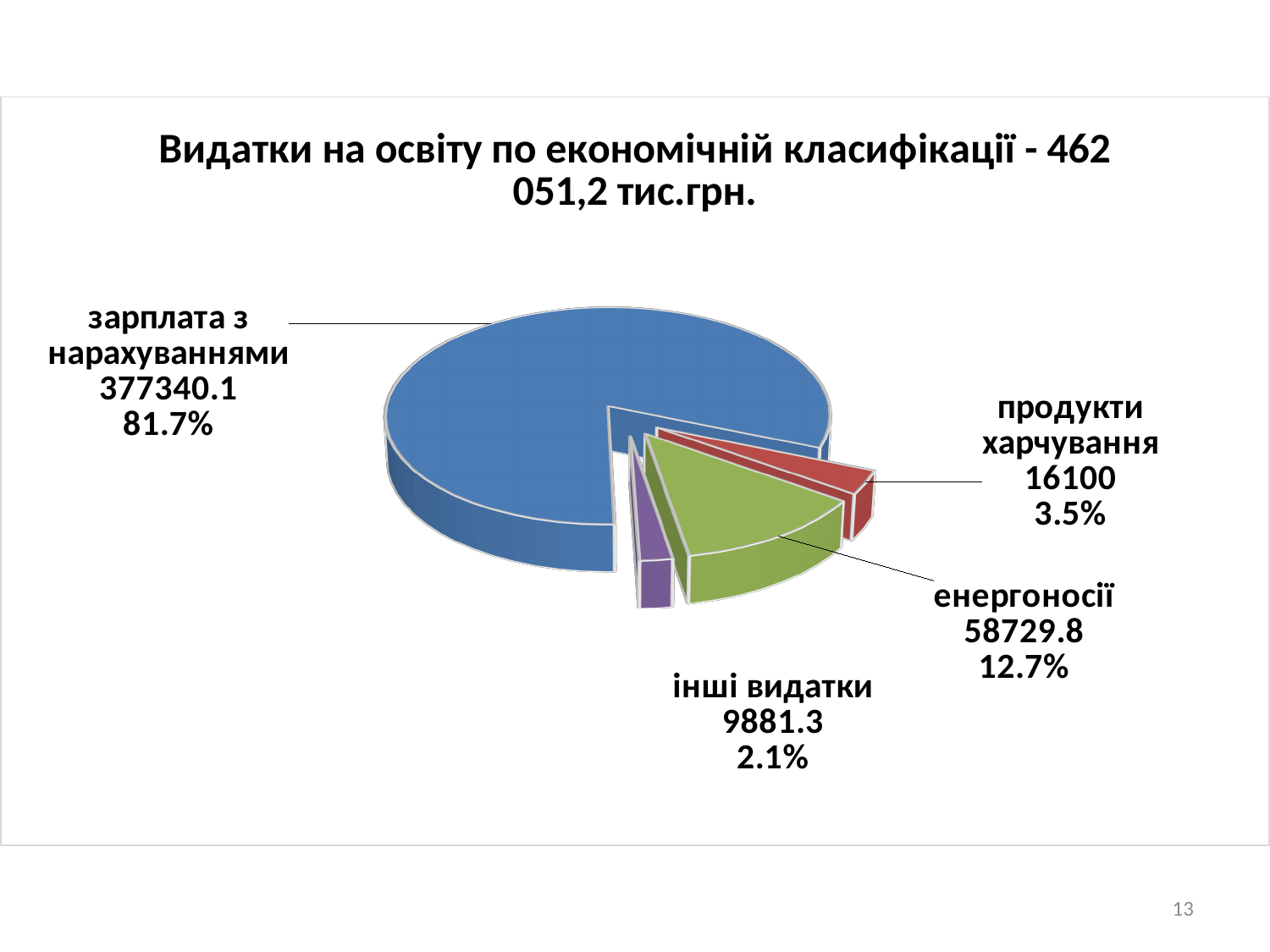
What is the value for енергоносії? 58729.8 What kind of chart is shown on the slide? pie chart Which category has the smallest slice? інші видатки What is the value for інші видатки? 9881.3 What share of the pie does енергоносії represent? 12.7% Which is larger, продукти харчування or енергоносії? енергоносії What share of the pie does зарплата з нарахуваннями represent? 81.7% What is the value for зарплата з нарахуваннями? 377340.1 Which category has the largest slice? зарплата з нарахуваннями What is the value for продукти харчування? 16100 What is the difference between the values for енергоносії and продукти харчування? 42629.8 How many categories are shown in the pie chart? 4